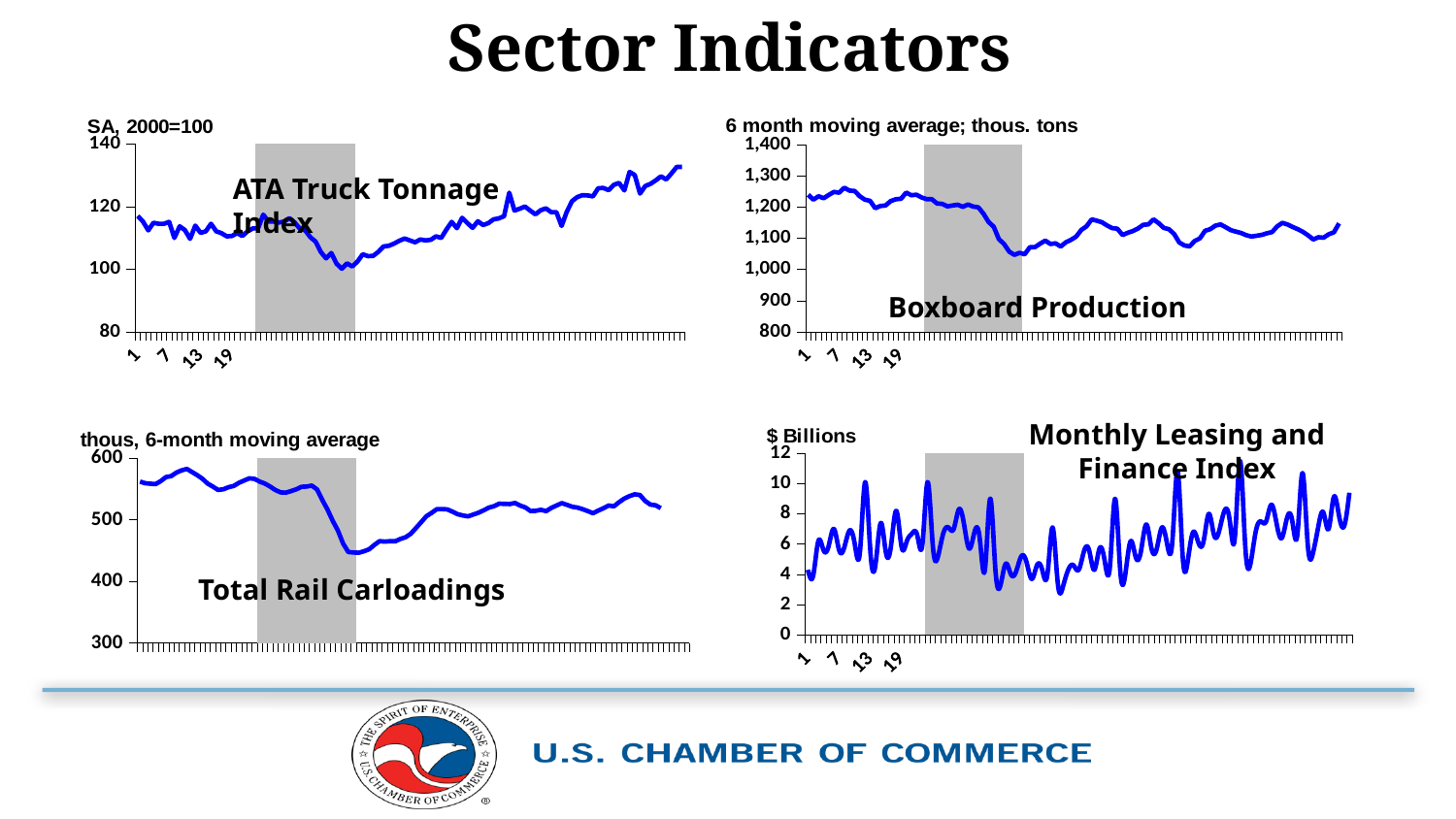
In the ATA Truck Tonnage Index chart, is the lowest point of the series greater or less than 110? less How many charts are shown on the slide? 4 What unit is shown on the y-axis label of the Monthly Leasing and Finance Index chart? $ Billions In the Total Rail Carloadings chart, does the series rise or fall across the shaded region? fall In the ATA Truck Tonnage Index chart, is the value at the end of the series higher or lower than at the start? higher In the Total Rail Carloadings chart, is the lowest point of the series greater or less than 500? less In the ATA Truck Tonnage Index chart, is the final value of the series greater or less than 120? greater What type of chart is the ATA Truck Tonnage Index chart? Line chart What is the y-axis label of the ATA Truck Tonnage Index chart? SA, 2000=100 In the Boxboard Production chart, is the value at the end of the series higher or lower than at the start? lower